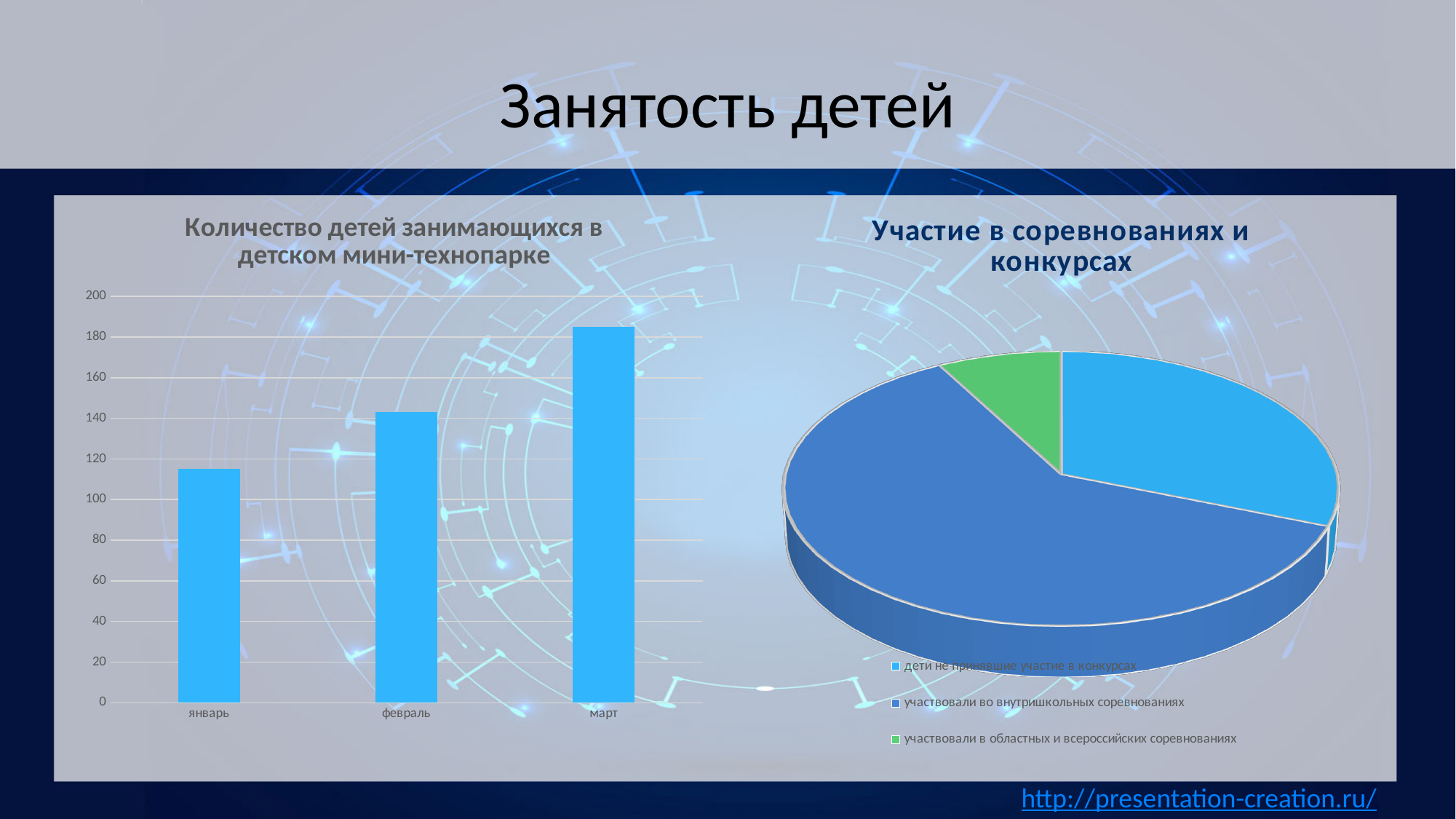
In the chart "Количество детей занимающихся в детском мини-технопарке", how many categories are shown on the x axis? 3 What kind of chart is the chart titled "Количество детей занимающихся в детском мини-технопарке"? bar chart In the chart "Количество детей занимающихся в детском мини-технопарке", which is larger, the value for февраль or the value for март? март In the chart "Количество детей занимающихся в детском мини-технопарке", is the value for февраль greater or less than 120? greater In the chart "Количество детей занимающихся в детском мини-технопарке", which month has the highest value? март How many entries does the legend of the chart "Участие в соревнованиях и конкурсах" list? 3 In the chart "Количество детей занимающихся в детском мини-технопарке", is the value for март greater or less than 160? greater In the chart "Количество детей занимающихся в детском мини-технопарке", which month has the lowest value? январь In the chart "Количество детей занимающихся в детском мини-технопарке", is the value for январь greater or less than 120? less In the chart "Количество детей занимающихся в детском мини-технопарке", do the values rise or fall from январь to март? rise What kind of chart is the chart titled "Участие в соревнованиях и конкурсах"? pie chart In the chart "Участие в соревнованиях и конкурсах", which legend entry corresponds to the smallest slice? участвовали в областных и всероссийских соревнованиях